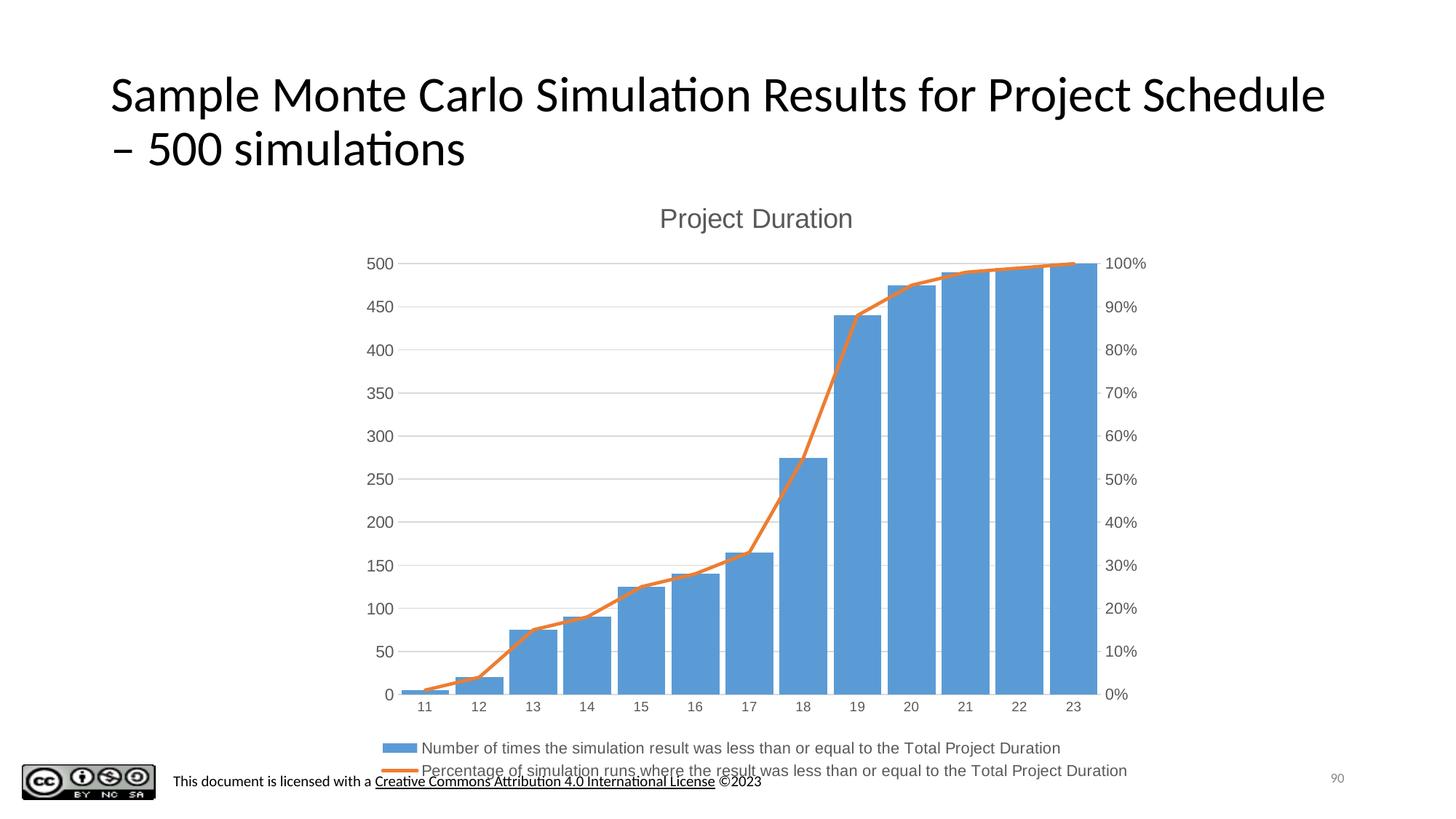
What colour is the percentage line in the chart? Orange Is the bar value for project duration 18 greater or less than 250? greater What is the title of the chart? Project Duration How many project duration categories are shown on the x axis? 13 How many series does the legend list? 2 Do the bar values rise or fall as project duration increases along the x axis? Rise Is the bar value for project duration 13 greater or less than 50? greater What kind of chart is shown on the slide? A bar chart with a line overlay Which project duration has the tallest bar? 23 Is the bar value for project duration 12 greater or less than 50? less Which project duration has the shortest bar? 11 Which has the larger bar value, project duration 17 or project duration 18? 18